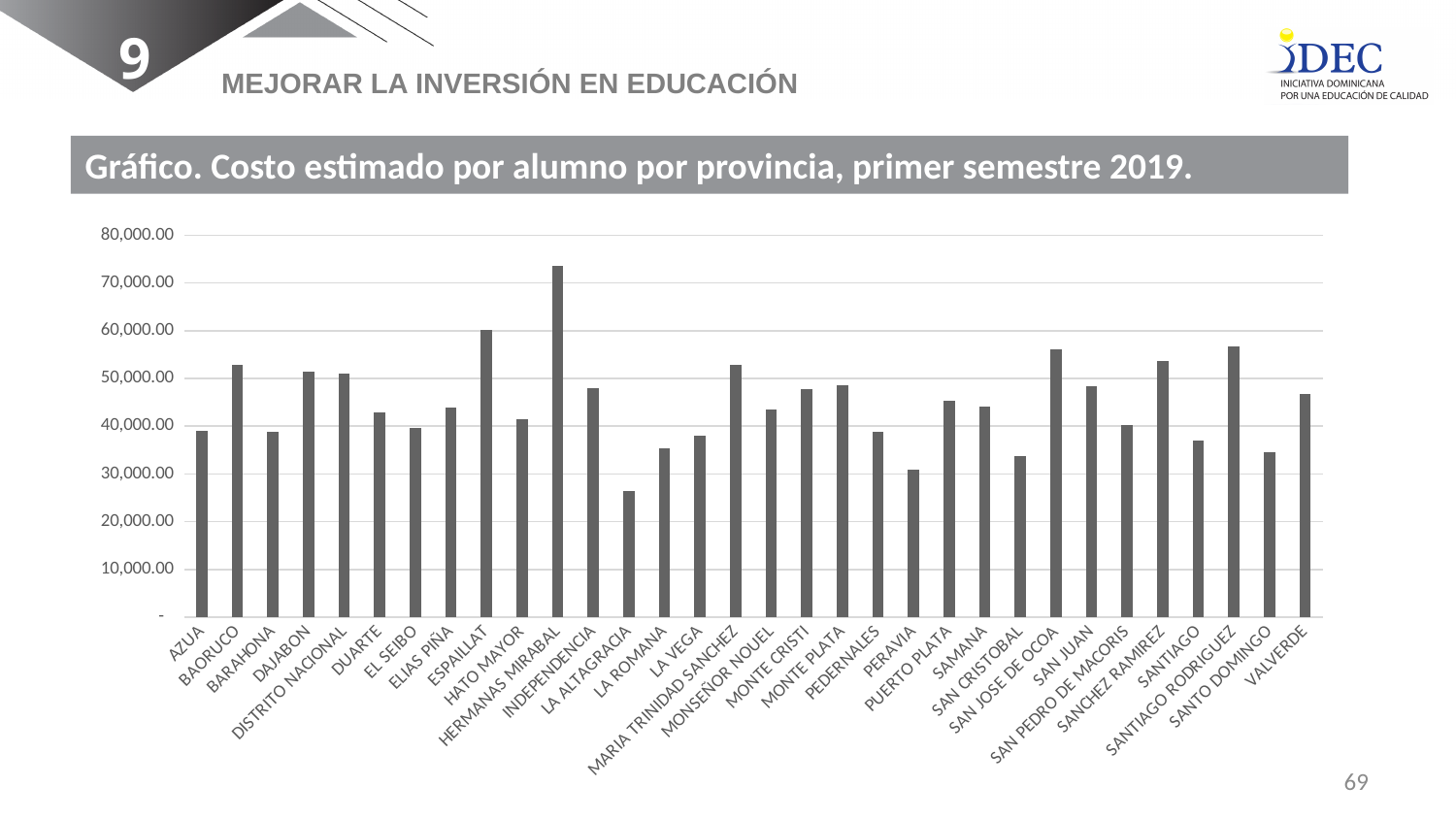
Which has a higher value, SAN JUAN or SANTIAGO? SAN JUAN Is the value for HERMANAS MIRABAL greater or less than 70,000.00? greater How many provinces are shown on the x axis? 32 Is the value for SAN JOSE DE OCOA greater or less than 50,000.00? greater What is the title of the chart? Gráfico. Costo estimado por alumno por provincia, primer semestre 2019. Is the value for LA ALTAGRACIA greater or less than 30,000.00? less Which province has the highest estimated cost per student? HERMANAS MIRABAL What kind of chart is shown on the slide? bar chart Which has a higher value, HERMANAS MIRABAL or ESPAILLAT? HERMANAS MIRABAL Which province has the lowest estimated cost per student? LA ALTAGRACIA Which has a lower value, PERAVIA or PUERTO PLATA? PERAVIA